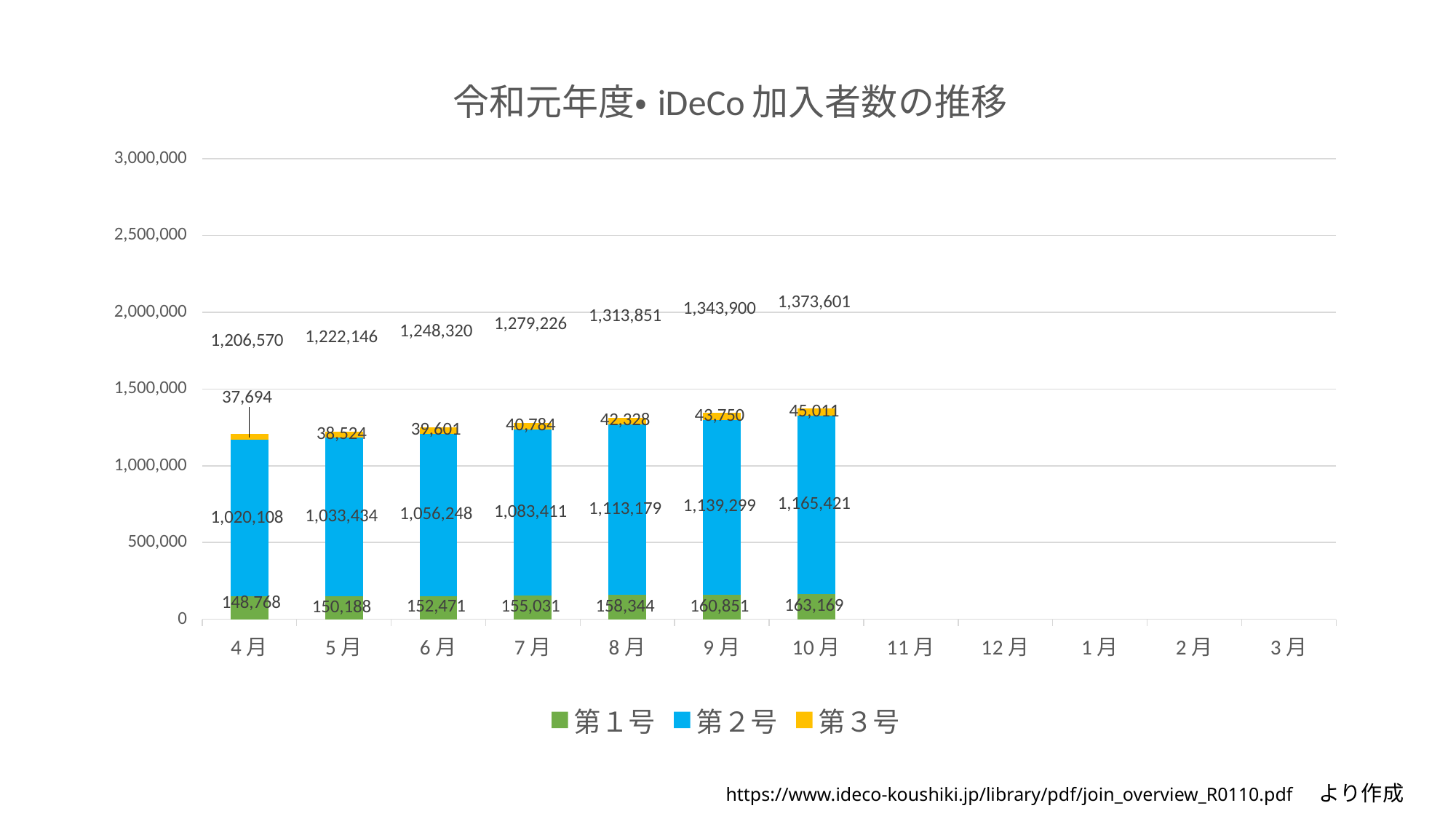
Which month has the highest total number of iDeCo subscribers? 10月 Which is larger, the 第１号 value for 8月 or for 6月? 8月 What type of chart is shown on the slide? stacked bar chart How many months have data plotted in the chart? 7 What is the value for 第２号 in 7月? 1,083,411 What is the value for 第１号 in 10月? 163,169 How many series does the legend list? 3 Do the total values rise or fall from 4月 to 10月? rise Which month has the lowest value for 第２号? 4月 What is the value for 第３号 in 5月? 38,524 What is the total of the stacked bar for 4月? 1,206,570 What is the difference between the 第２号 values for 10月 and 9月? 26,122